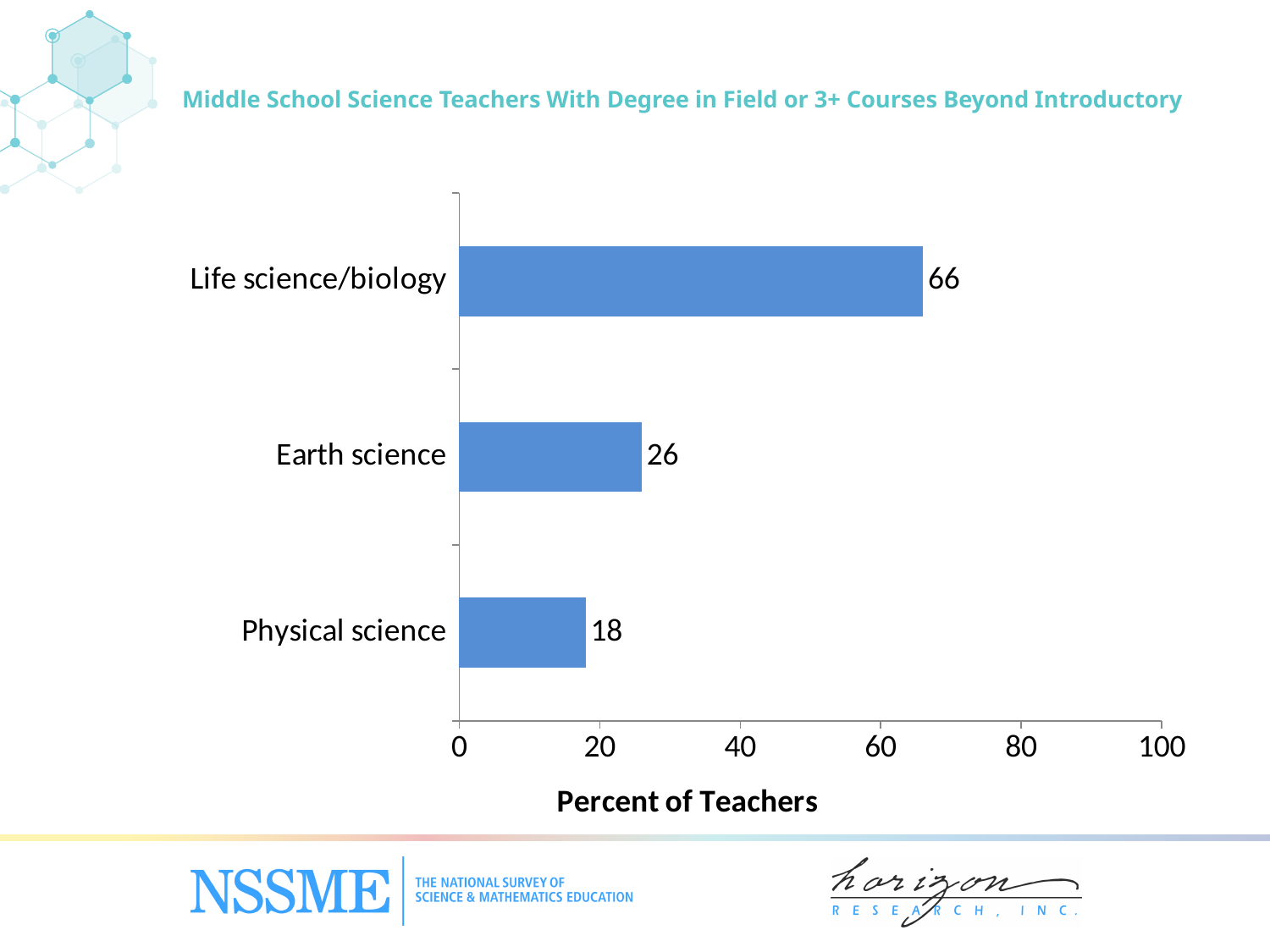
Which category has the lowest percent of teachers? Physical science What is the label of the horizontal axis? Percent of Teachers How many categories are shown in the chart? 3 What is the difference between the values for Life science/biology and Earth science? 40 Which category has the highest percent of teachers? Life science/biology What is the difference between the values for Earth science and Physical science? 8 Which is larger, the value for Earth science or the value for Physical science? Earth science Is the value for Life science/biology greater or less than 60? greater What is the value for Earth science? 26 What kind of chart is shown on the slide? bar chart What is the value for Life science/biology? 66 What is the value for Physical science? 18